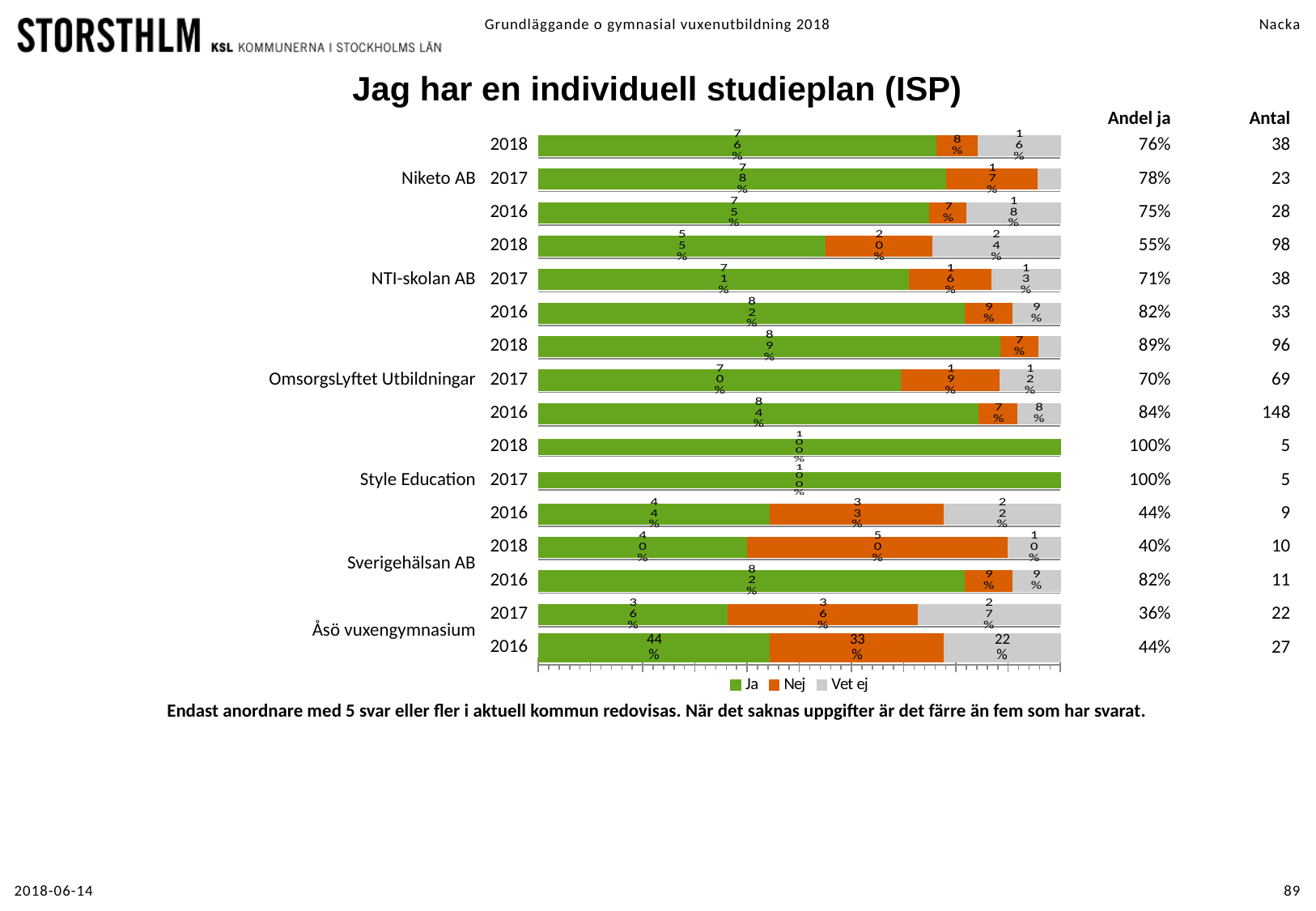
Which bar has the highest 'Ja' share? Style Education 2018 and 2017 (100%) How many series does the legend list? 3 What is the 'Ja' share for Niketo AB in 2018? 76% What is the 'Nej' share for NTI-skolan AB in 2018? 20% What are the three legend entries of the chart? Ja, Nej, Vet ej What is the 'Ja' share for OmsorgsLyftet Utbildningar in 2018? 89% Which is larger: the 'Ja' share for Sverigehälsan AB in 2018 or the 'Nej' share for Sverigehälsan AB in 2018? Nej (50%) What is the difference between the 'Ja' share for NTI-skolan AB in 2016 and in 2018? 27 percentage points Which bar has the lowest 'Ja' share? Åsö vuxengymnasium 2017 How many bars are plotted in the chart? 16 What kind of chart is shown on the slide? bar chart What is the 'Vet ej' share for Åsö vuxengymnasium in 2016? 22%